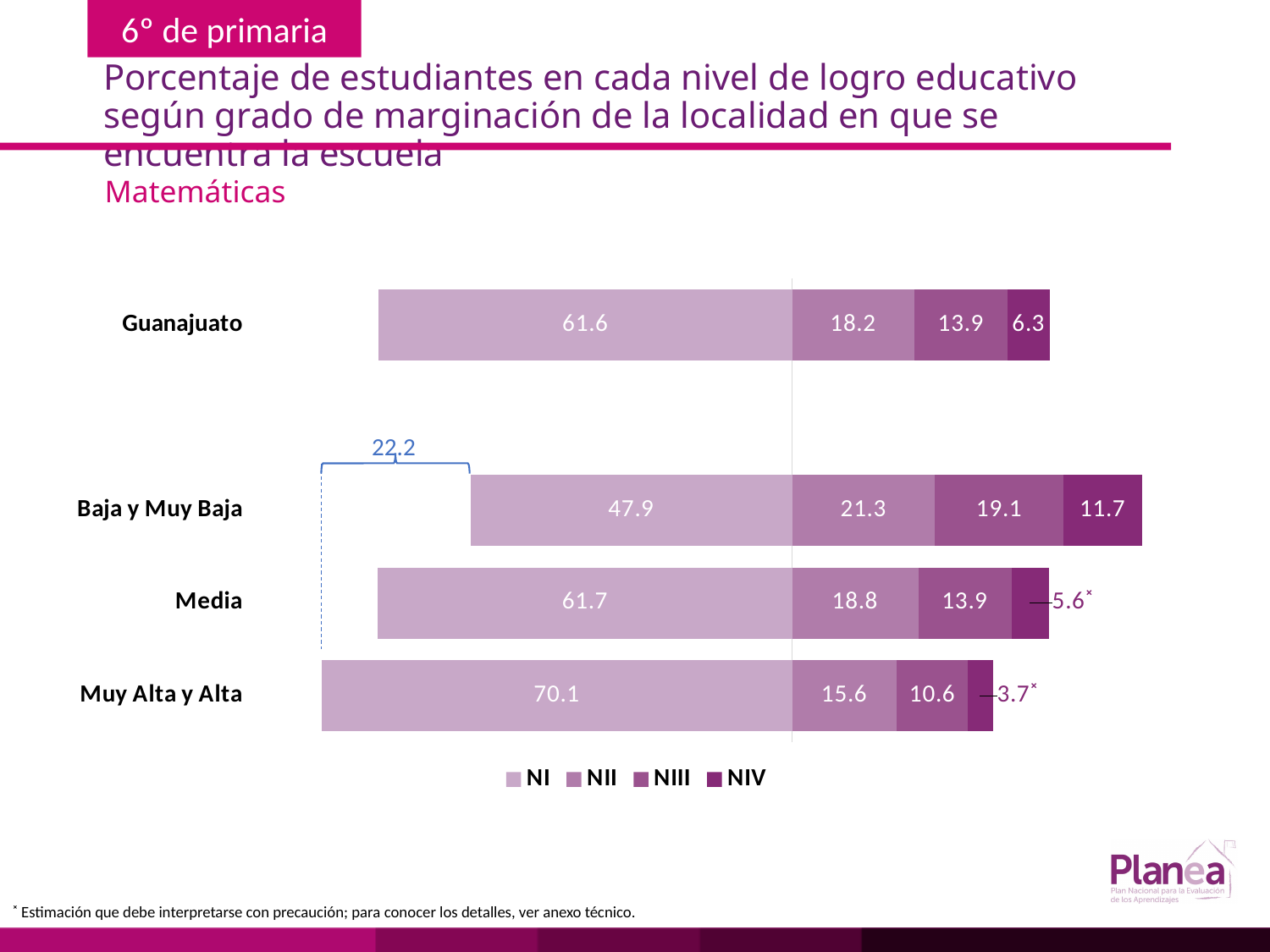
Which category has the highest NI value? Muy Alta y Alta What is the difference between the NI values of Muy Alta y Alta and Baja y Muy Baja? 22.2 How many categories (bars) are shown in the chart? 4 What is the NIII value for Media? 13.9 What is the total of the stacked bar for Guanajuato? 100.0 Which category has the lowest NIV value? Muy Alta y Alta What is the NII value for Muy Alta y Alta? 15.6 What is the NI value for Guanajuato? 61.6 Which is larger, the NII value for Baja y Muy Baja or the NII value for Media? Baja y Muy Baja How many series does the legend list? 4 What kind of chart is shown on the slide? Stacked bar chart What is the NIV value for Baja y Muy Baja? 11.7